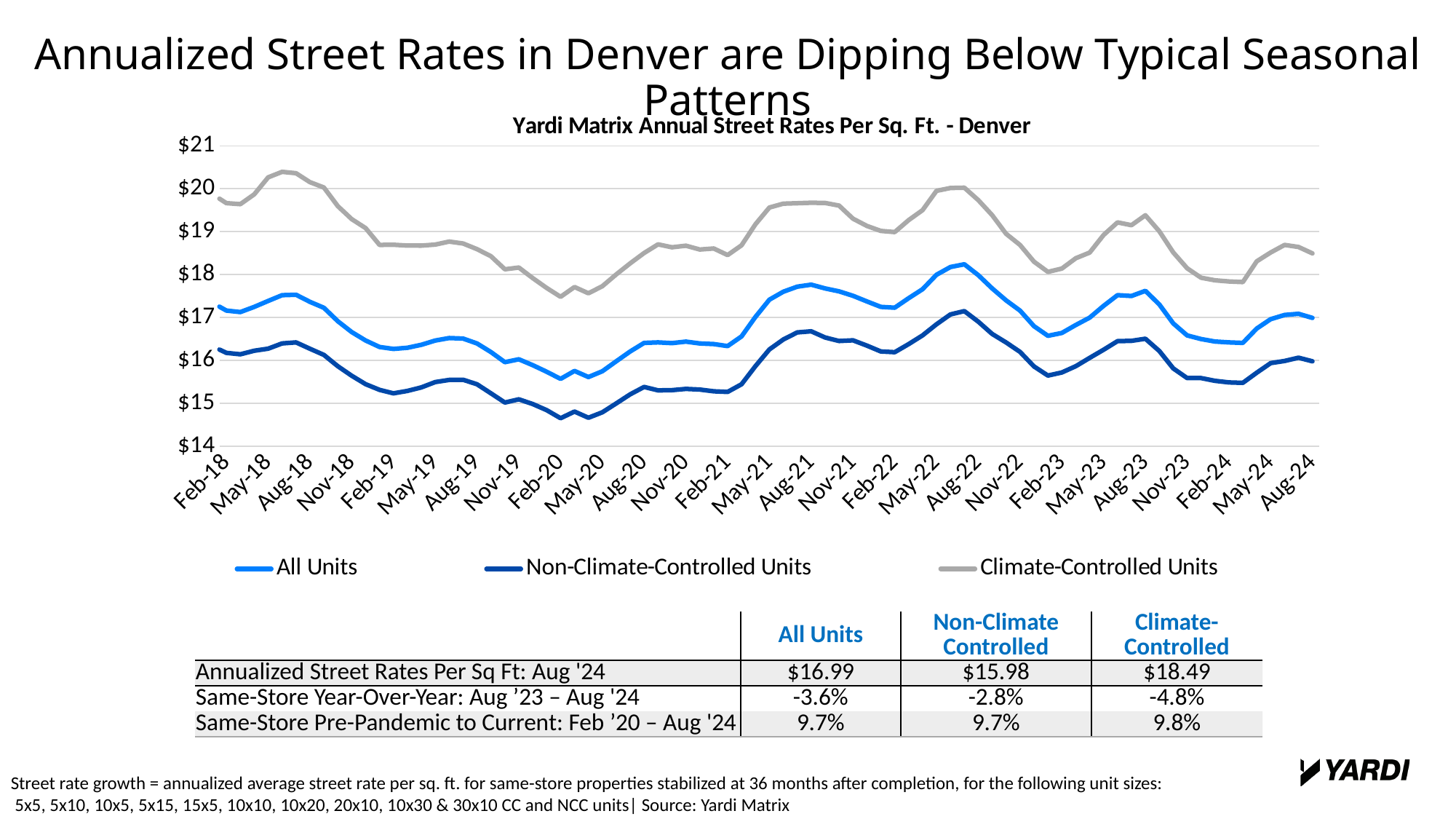
What kind of chart is shown on the slide? Line chart Which series is drawn in gray on the chart? Climate-Controlled Units How many series does the chart legend list? 3 What is the annualized street rate per sq ft for Climate-Controlled units in Aug '24? $18.49 Which series has the lowest street rates across the whole period shown? Non-Climate-Controlled Units What is the difference between the Aug '24 street rates for Climate-Controlled and Non-Climate-Controlled units? $2.51 Do the All Units street rates rise or fall between Aug-22 and Feb-23? fall Is the value for Non-Climate-Controlled Units in Feb-20 greater or less than $15? less Which series has the highest street rates across the whole period shown? Climate-Controlled Units Is the value for Climate-Controlled Units in Aug-18 greater or less than $20? greater What is the annualized street rate per sq ft for All Units in Aug '24? $16.99 What is the title of the chart? Yardi Matrix Annual Street Rates Per Sq. Ft. - Denver